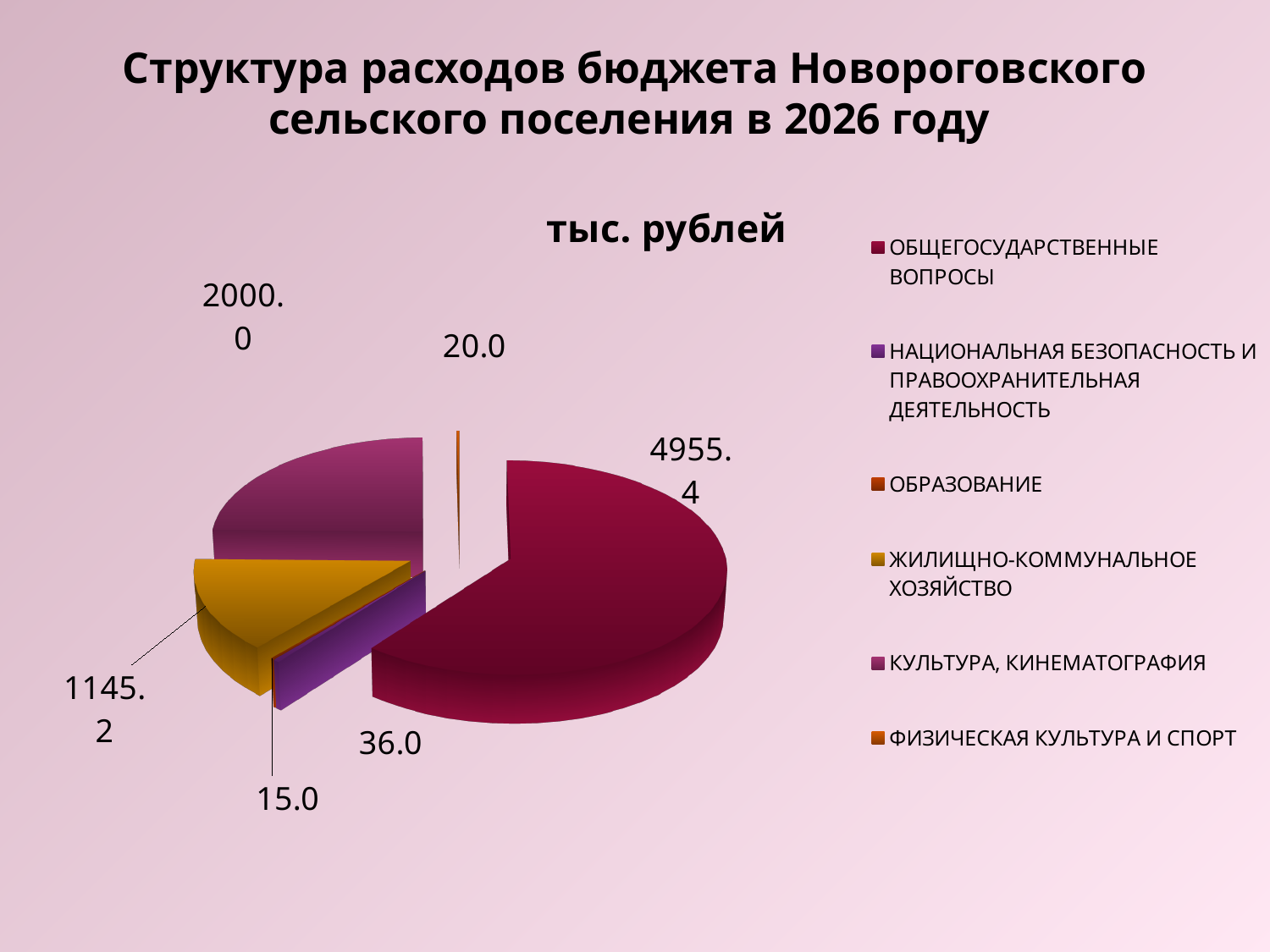
What is the title of the chart? тыс. рублей What is the difference between the values for КУЛЬТУРА, КИНЕМАТОГРАФИЯ and ЖИЛИЩНО-КОММУНАЛЬНОЕ ХОЗЯЙСТВО? 854.8 What is the value for НАЦИОНАЛЬНАЯ БЕЗОПАСНОСТЬ И ПРАВООХРАНИТЕЛЬНАЯ ДЕЯТЕЛЬНОСТЬ? 36.0 What is the value for ЖИЛИЩНО-КОММУНАЛЬНОЕ ХОЗЯЙСТВО? 1145.2 What is the value for ОБЩЕГОСУДАРСТВЕННЫЕ ВОПРОСЫ? 4955.4 Which category has the smallest slice of the pie? ОБРАЗОВАНИЕ What is the value for КУЛЬТУРА, КИНЕМАТОГРАФИЯ? 2000.0 Which is larger: the value for НАЦИОНАЛЬНАЯ БЕЗОПАСНОСТЬ И ПРАВООХРАНИТЕЛЬНАЯ ДЕЯТЕЛЬНОСТЬ or the value for ФИЗИЧЕСКАЯ КУЛЬТУРА И СПОРТ? НАЦИОНАЛЬНАЯ БЕЗОПАСНОСТЬ И ПРАВООХРАНИТЕЛЬНАЯ ДЕЯТЕЛЬНОСТЬ What is the value for ФИЗИЧЕСКАЯ КУЛЬТУРА И СПОРТ? 20.0 How many categories does the pie chart show? 6 What kind of chart is shown on the slide? Pie chart Which category has the largest slice of the pie? ОБЩЕГОСУДАРСТВЕННЫЕ ВОПРОСЫ